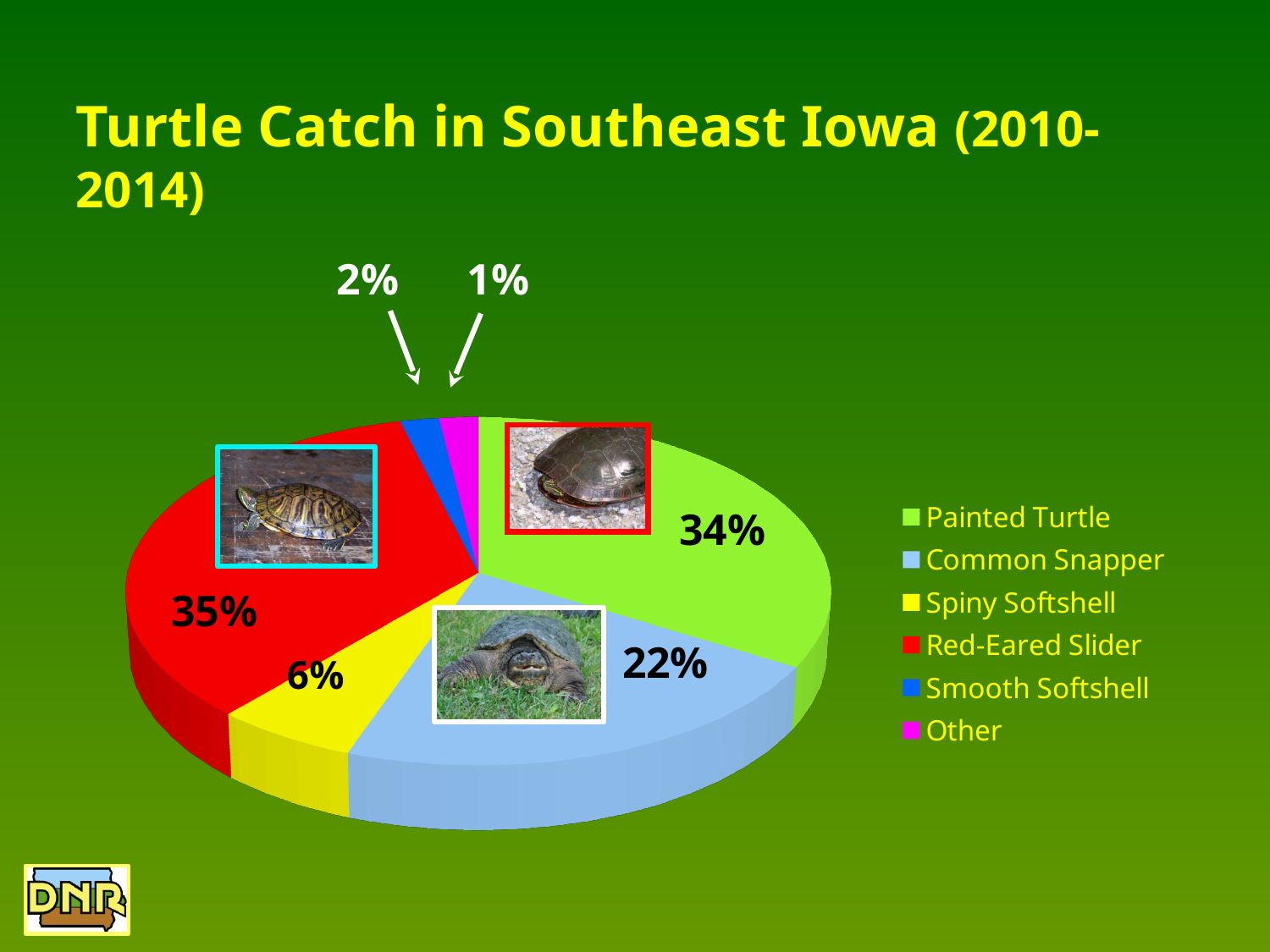
Which has a larger share of the catch, Common Snapper or Spiny Softshell? Common Snapper How many categories does the legend list? 6 What share of the turtle catch is Red-Eared Slider? 35% Which category has the smallest share of the turtle catch? Other What share of the turtle catch is Spiny Softshell? 6% What share of the turtle catch is Common Snapper? 22% What kind of chart is shown on the slide? Pie chart Which category has the largest share of the turtle catch? Red-Eared Slider What colour represents Smooth Softshell in the chart? Blue What is the difference in share between Painted Turtle and Common Snapper? 12%